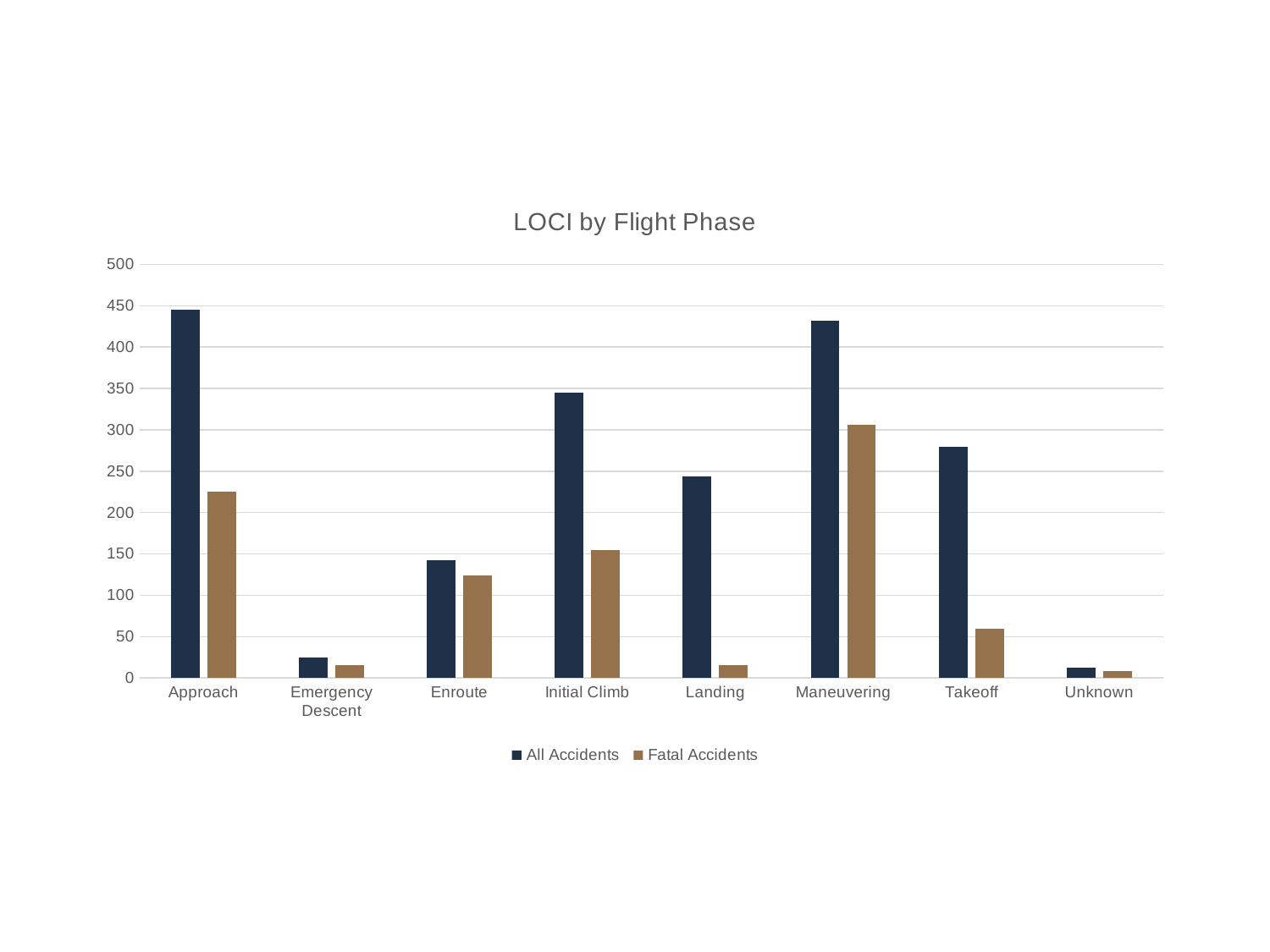
How many series does the legend list? 2 How many flight phase categories are shown on the x axis? 8 Is the All Accidents value for Approach greater or less than 400? greater Is the All Accidents value for Takeoff greater or less than 250? greater Is the Fatal Accidents value for Maneuvering greater or less than 250? greater What is the title of the chart? LOCI by Flight Phase Which flight phase has the highest value for Fatal Accidents? Maneuvering Which is larger, the Fatal Accidents value for Approach or for Maneuvering? Maneuvering What kind of chart is shown on the slide? bar chart Which flight phase has the lowest value for All Accidents? Unknown Which is larger, the All Accidents value for Landing or for Takeoff? Takeoff